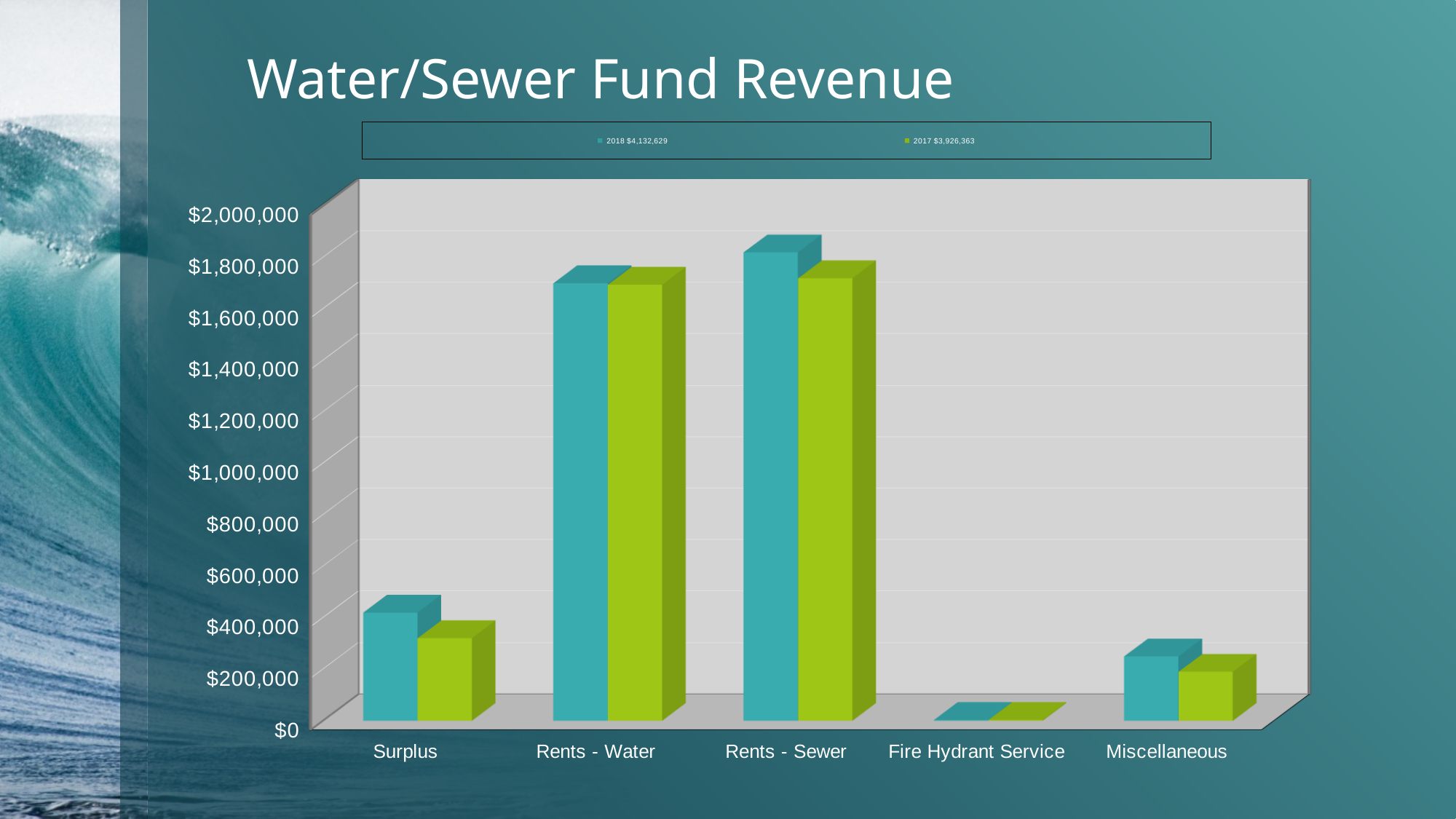
Which category has the lowest value for the 2018 series? Fire Hydrant Service Is the 2018 value for Surplus greater or less than $600,000? less How many series does the chart's legend list? 2 Which category has the highest value for the 2018 series? Rents - Sewer How many categories are shown on the x axis of the chart? 5 Is the 2018 value for Rents - Water greater or less than $1,600,000? greater Is the 2017 value for Fire Hydrant Service greater or less than $200,000? less For the 2018 series, which is larger, Rents - Sewer or Rents - Water? Rents - Sewer What kind of chart is shown on the slide? Bar chart What is the title of the slide's chart? Water/Sewer Fund Revenue For Surplus, which series has the larger value, 2018 or 2017? 2018